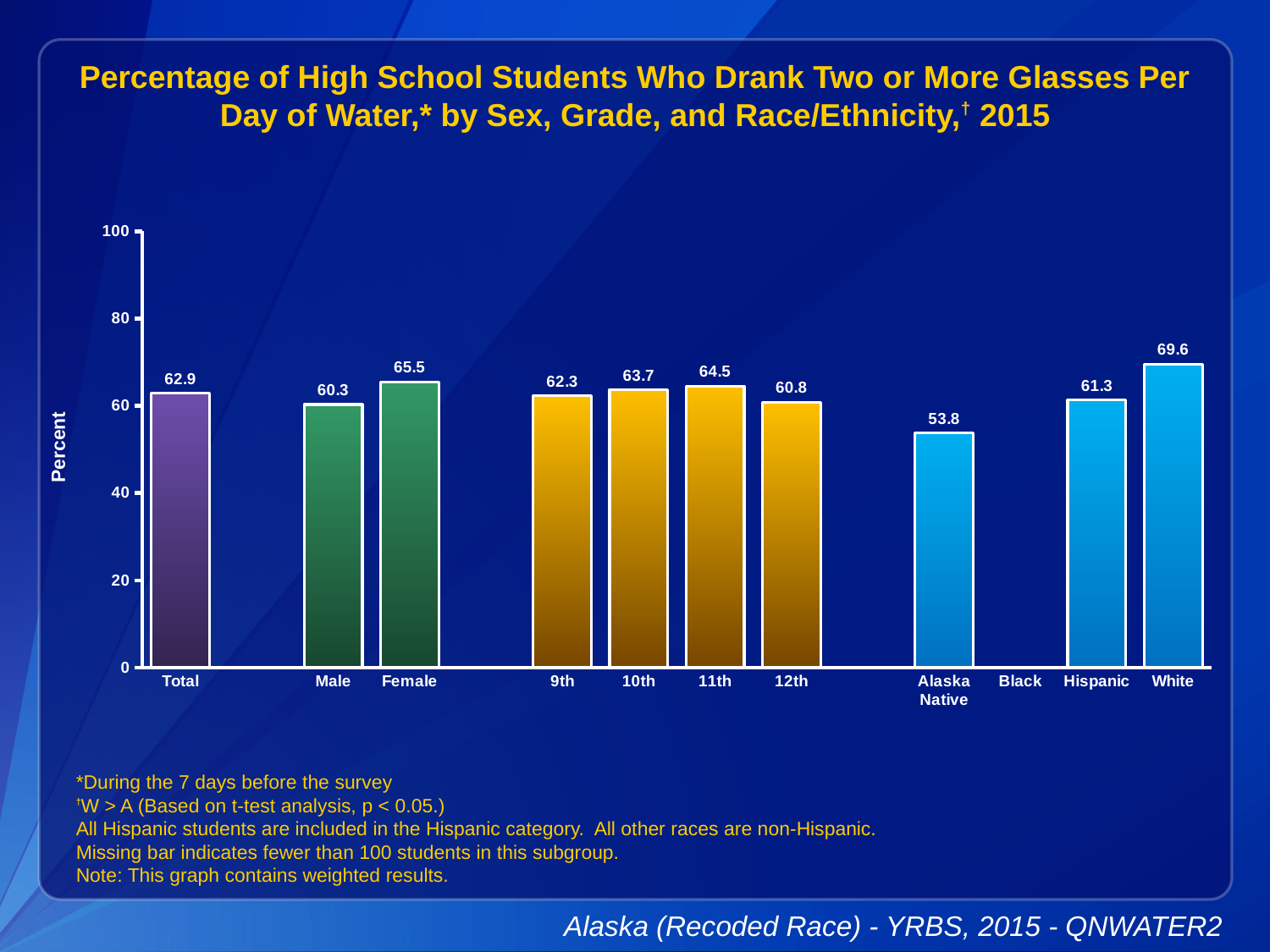
What is the value for Female? 65.5 How many bars are plotted on the chart? 10 Is the value for Hispanic greater or less than 60? greater Which category has the highest value? White What is the difference between the Female and Male values? 5.2 Which is larger, the value for 11th grade or the value for 12th grade? 11th Which category label has no bar plotted? Black Which category has the lowest value among the bars shown? Alaska Native What kind of chart is shown on the slide? bar chart What is the value for Total? 62.9 What is the value for Alaska Native? 53.8 What is the label on the vertical axis? Percent